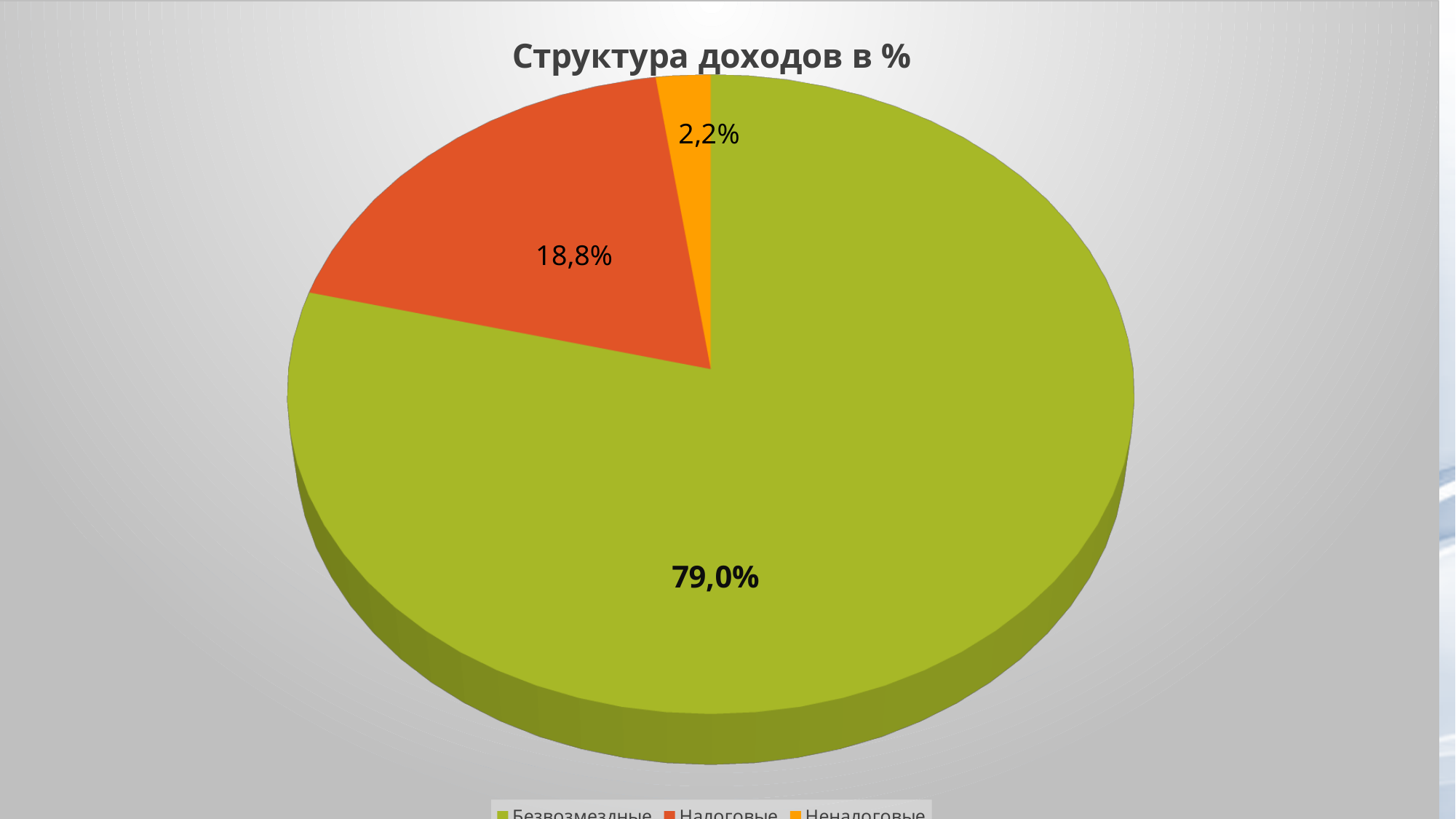
What is the title of the chart? Структура доходов в % Which is larger, the slice for Налоговые or the slice for Неналоговые? Налоговые How many slices does the pie chart have? 3 What is the difference in percentage points between Безвозмездные and Налоговые? 60,2 What kind of chart is shown on the slide? pie chart What share of the pie does Налоговые take? 18,8% What share of the pie does Неналоговые take? 2,2% Which category has the smallest slice of the pie? Неналоговые What is the difference in percentage points between Налоговые and Неналоговые? 16,6 What colour is the slice for Налоговые? red-orange Which category has the largest slice of the pie? Безвозмездные What share of the pie does Безвозмездные take? 79,0%